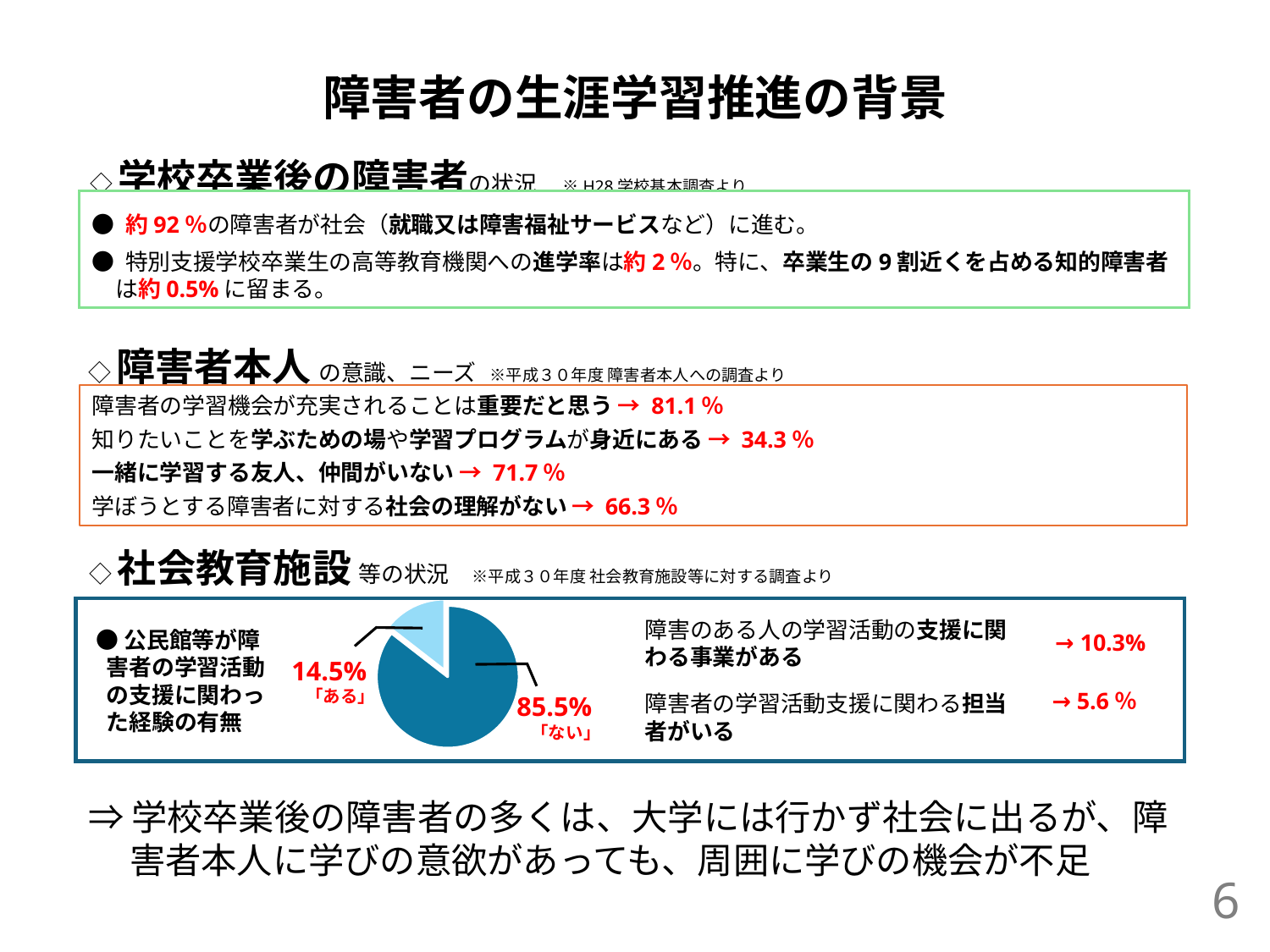
円グラフで「ある」と「ない」ではどちらの割合が大きいですか？ 「ない」 円グラフは何についての経験の有無を示していますか？ 公民館等が障害者の学習活動の支援に関わった経験の有無 このスライドのグラフはどの種類のグラフですか？ 円グラフ 円グラフで「ない」の区分は何色で示されていますか？ 濃い青 円グラフで「ない」と「ある」の割合の差は何ポイントですか？ 71ポイント 円グラフにはいくつの区分がありますか？ 2 円グラフで「ある」の割合は何％ですか？ 14.5% 円グラフの「ある」の割合は50%より大きいですか、小さいですか？ 小さい 円グラフで最も大きい割合を占める区分はどれですか？ 「ない」 円グラフで「ない」の割合は何％ですか？ 85.5% 円グラフで最も小さい割合を占める区分はどれですか？ 「ある」